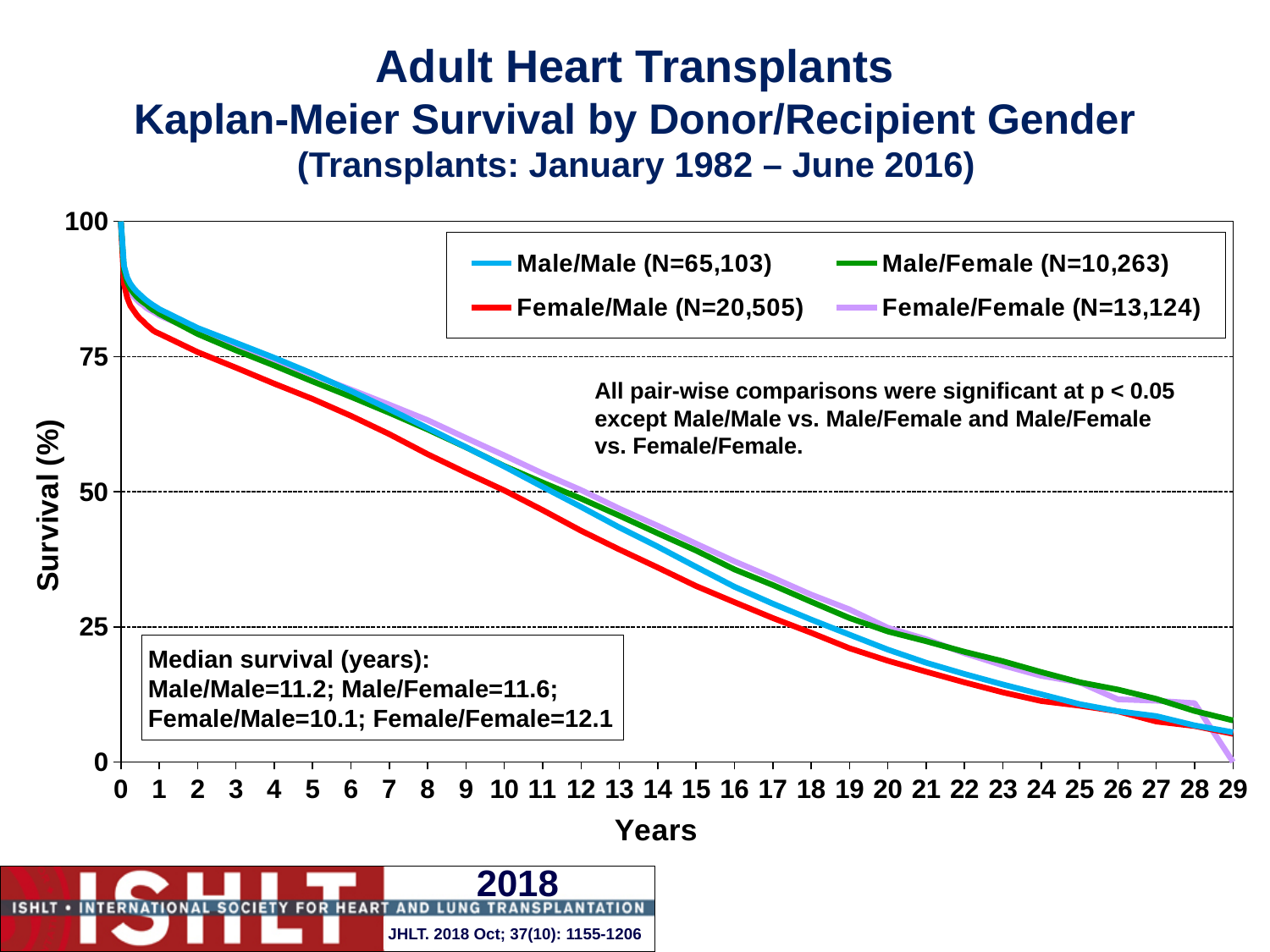
Do the survival curves rise or fall as years increase? Fall How many series does the legend list? 4 What kind of chart is shown on the slide? Line chart What is the N for the Male/Male group shown in the legend? 65,103 Which donor/recipient gender group has the lowest median survival? Female/Male What is the difference in median survival between Female/Female and Female/Male? 2.0 years What is the median survival in years for Female/Male transplants? 10.1 Which group has the larger median survival, Male/Male or Male/Female? Male/Female What is the label of the y axis? Survival (%) What is the median survival in years for Female/Female transplants? 12.1 Which donor/recipient gender group has the highest median survival? Female/Female Is the survival for Female/Male at 5 years greater or less than 50%? greater